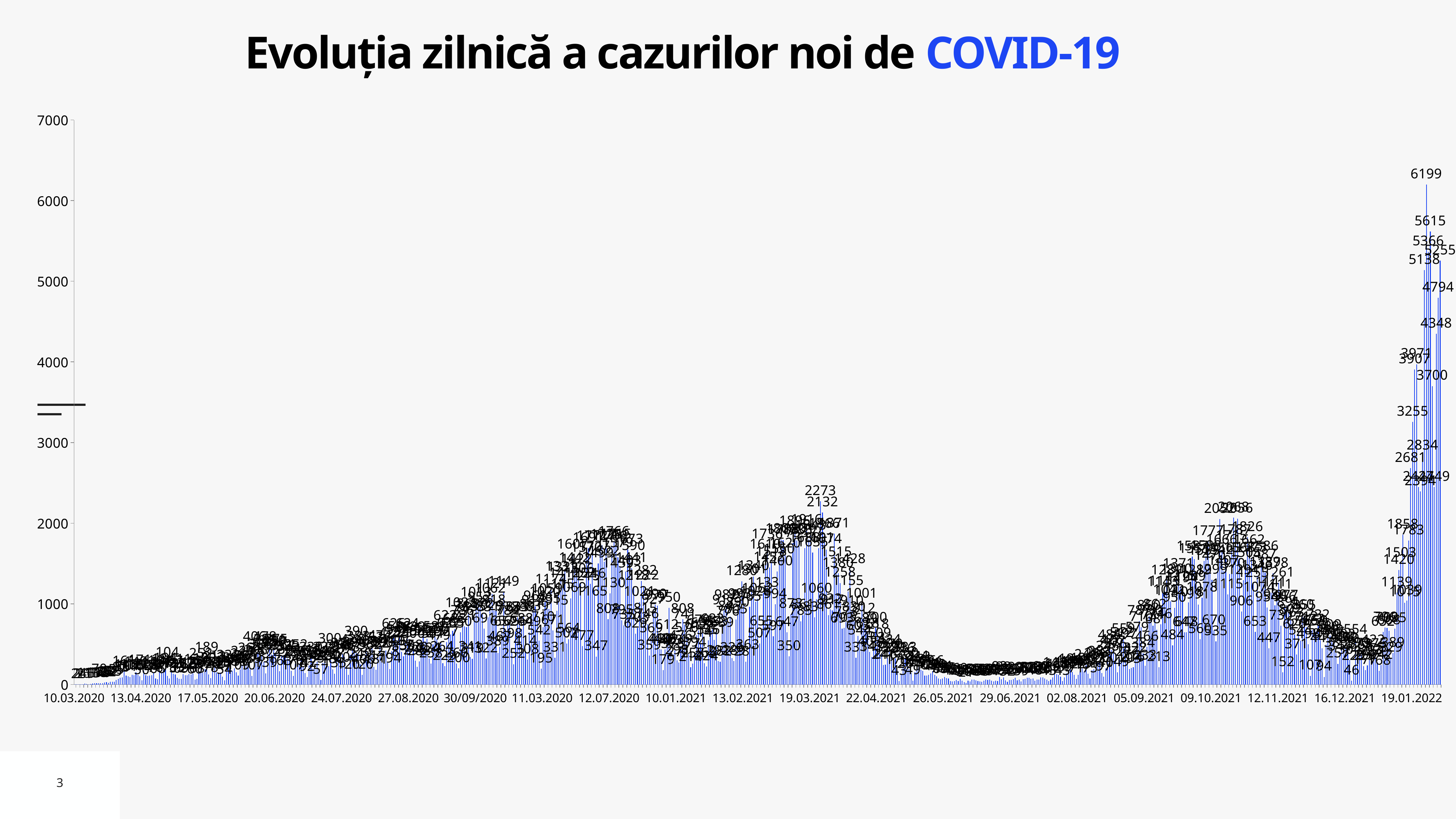
How many date labels are shown on the x axis? 21 Is the highest value on the chart greater or less than 6000? greater What kind of chart is shown on the slide? bar chart What is the highest daily value labelled on the chart? 6199 Which wave has the higher peak: the one around 19.03.2021 or the one around 19.01.2022? the one around 19.01.2022 Do the values rise or fall between 16.12.2021 and 19.01.2022? rise Do the values rise or fall between 22.04.2021 and 29.06.2021? fall Is the peak of the wave around 19.03.2021 greater or less than 2000? greater What is the title of the chart? Evoluția zilnică a cazurilor noi de COVID-19 What is the difference between the two highest labelled values, 6199 and 5615? 584 What is the highest labelled value of the wave around 19.03.2021? 2273 What is the highest value shown on the y axis? 7000